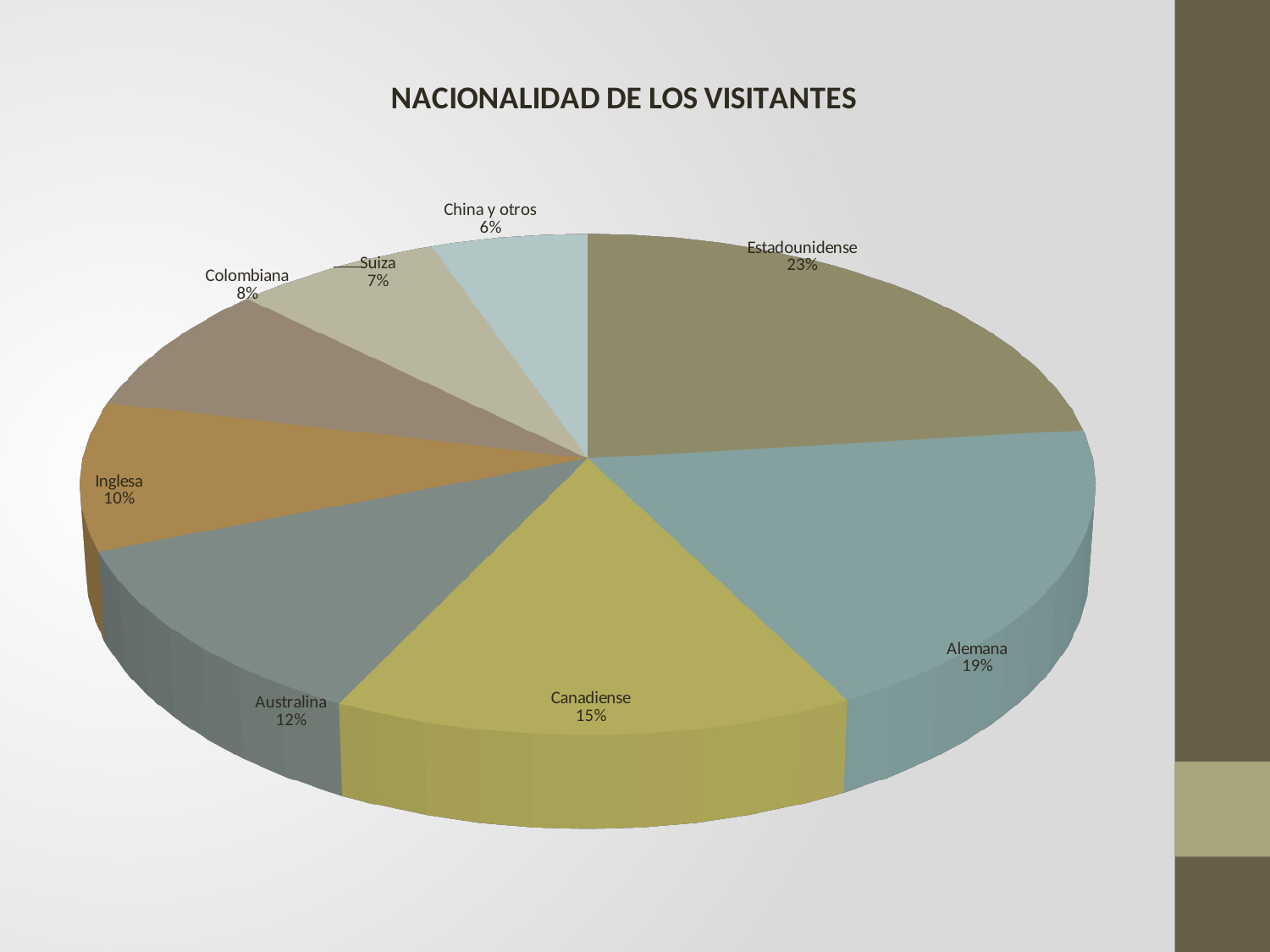
What kind of chart is shown on the slide? Pie chart What percentage is shown for Inglesa? 10% What share of visitors are Estadounidense? 23% What percentage is shown for Canadiense? 15% What is the difference in percentage points between Estadounidense and Alemana? 4 Which is larger, the Colombiana slice or the Suiza slice? Colombiana Which nationality has the largest slice of the pie? Estadounidense What share of visitors are Alemana? 19% How many nationality categories are shown in the pie chart? 8 What is the title of the chart? NACIONALIDAD DE LOS VISITANTES What percentage is shown for Australina? 12% Which nationality has the smallest slice of the pie? China y otros